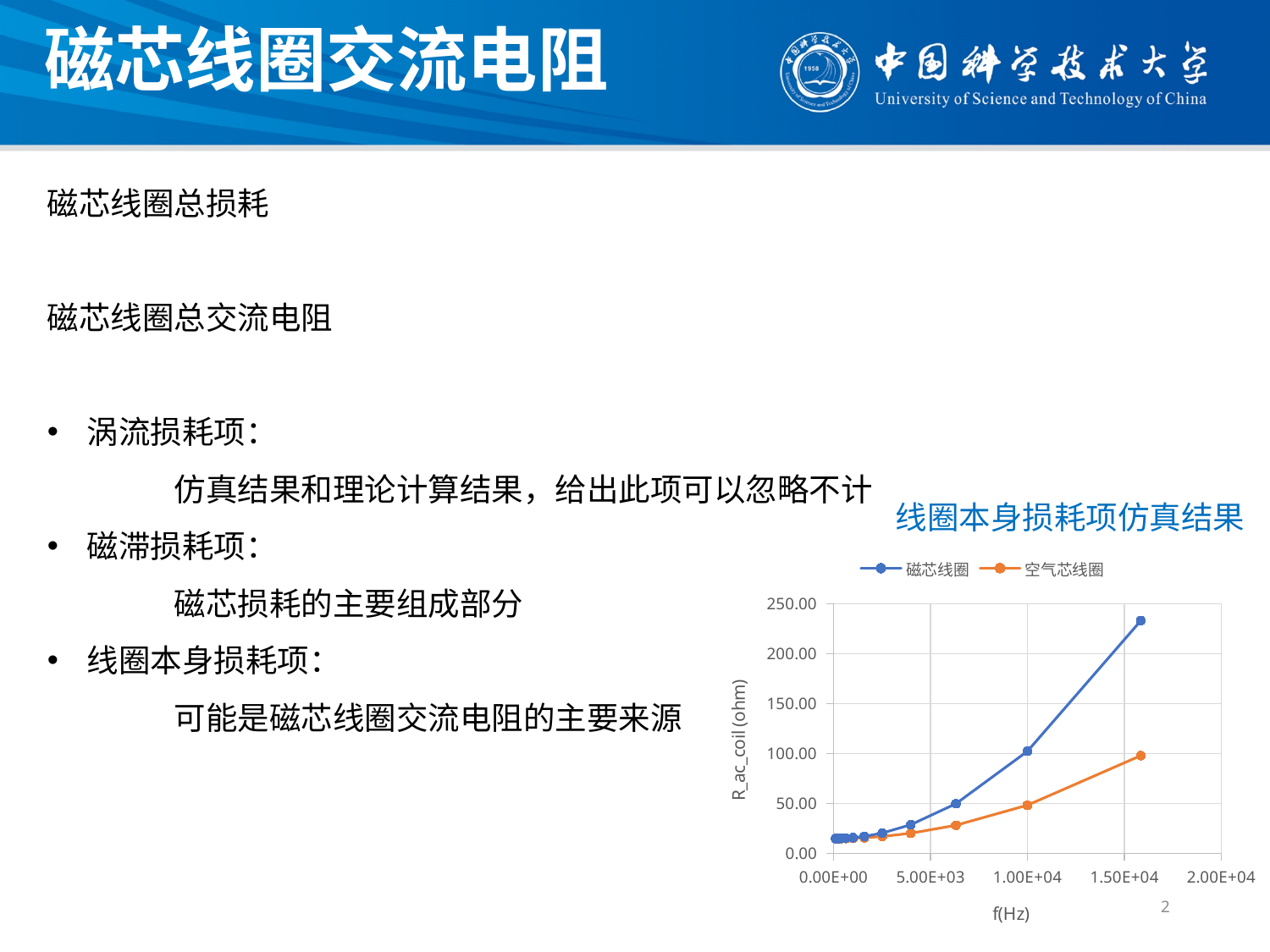
How many series does the chart legend list? 2 Does the 空气芯线圈 series rise or fall as f(Hz) increases? rise What kind of chart is shown on the slide? line chart At the highest frequency plotted, which series has the larger R_ac_coil value, 磁芯线圈 or 空气芯线圈? 磁芯线圈 Is the R_ac_coil value of 空气芯线圈 at its highest plotted frequency greater or less than 150.00? less Is the R_ac_coil value of 磁芯线圈 at f = 1.00E+04 Hz greater or less than 50.00? greater Does the 磁芯线圈 series rise or fall as f(Hz) increases? rise Is the R_ac_coil value of 磁芯线圈 at its highest plotted frequency greater or less than 200.00? greater Which series reaches the highest R_ac_coil value on the chart? 磁芯线圈 What are the two series named in the chart legend? 磁芯线圈 and 空气芯线圈 What is the title of the chart? 线圈本身损耗项仿真结果